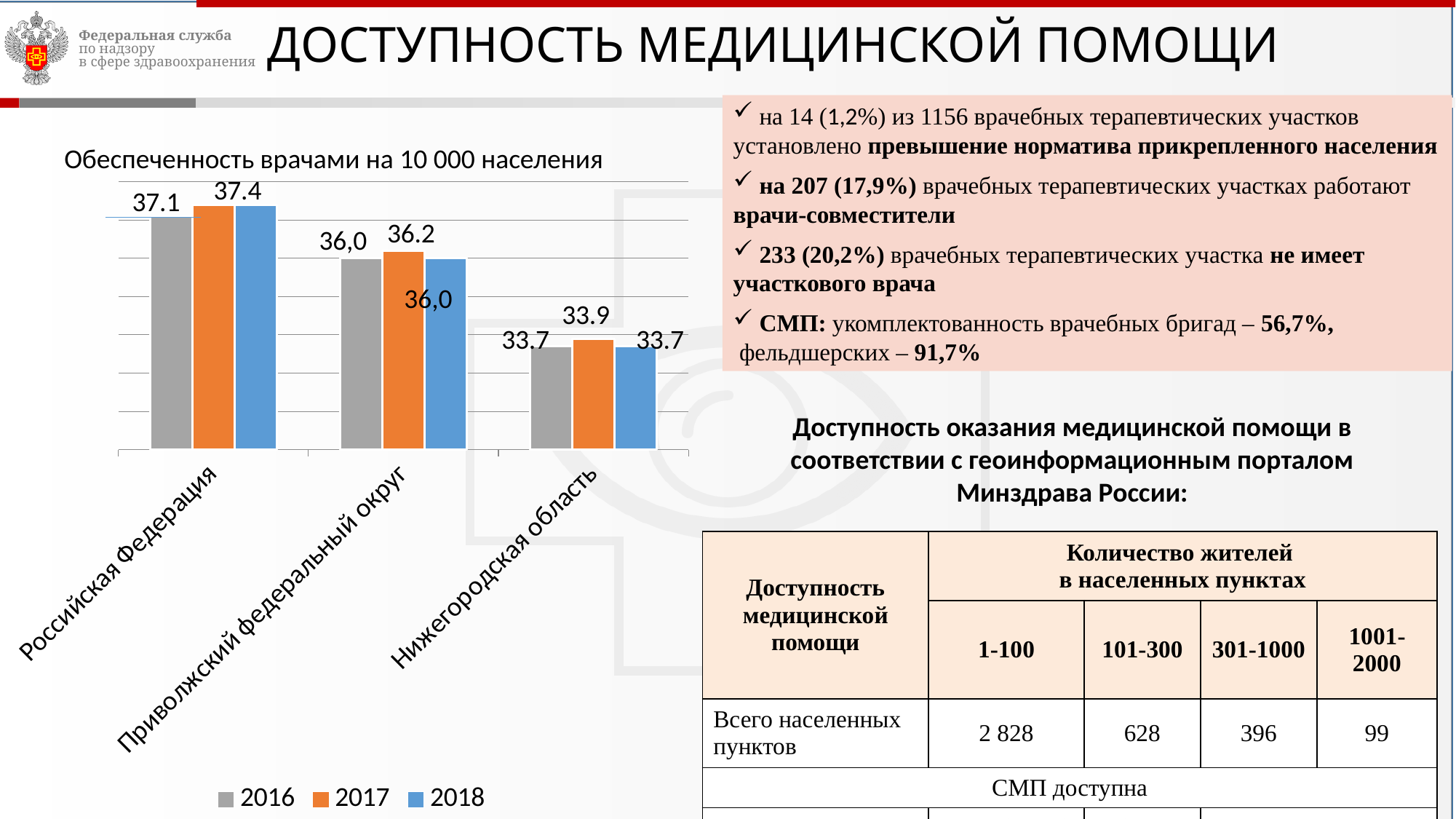
What kind of chart is shown on the slide? bar chart How many categories are shown on the x axis of the chart? 3 What is the 2017 value for Российская Федерация? 37.4 Which category has the lowest 2017 value? Нижегородская область What is the 2017 value for Нижегородская область? 33.9 What is the 2016 value for Российская Федерация? 37.1 Which category has the highest 2016 value? Российская Федерация What is the 2017 value for Приволжский федеральный округ? 36.2 How many series does the chart legend list? 3 What is the 2016 value for Нижегородская область? 33.7 What is the title of the chart on the slide? Обеспеченность врачами на 10 000 населения What is the difference between the 2017 values for Российская Федерация and Нижегородская область? 3.5